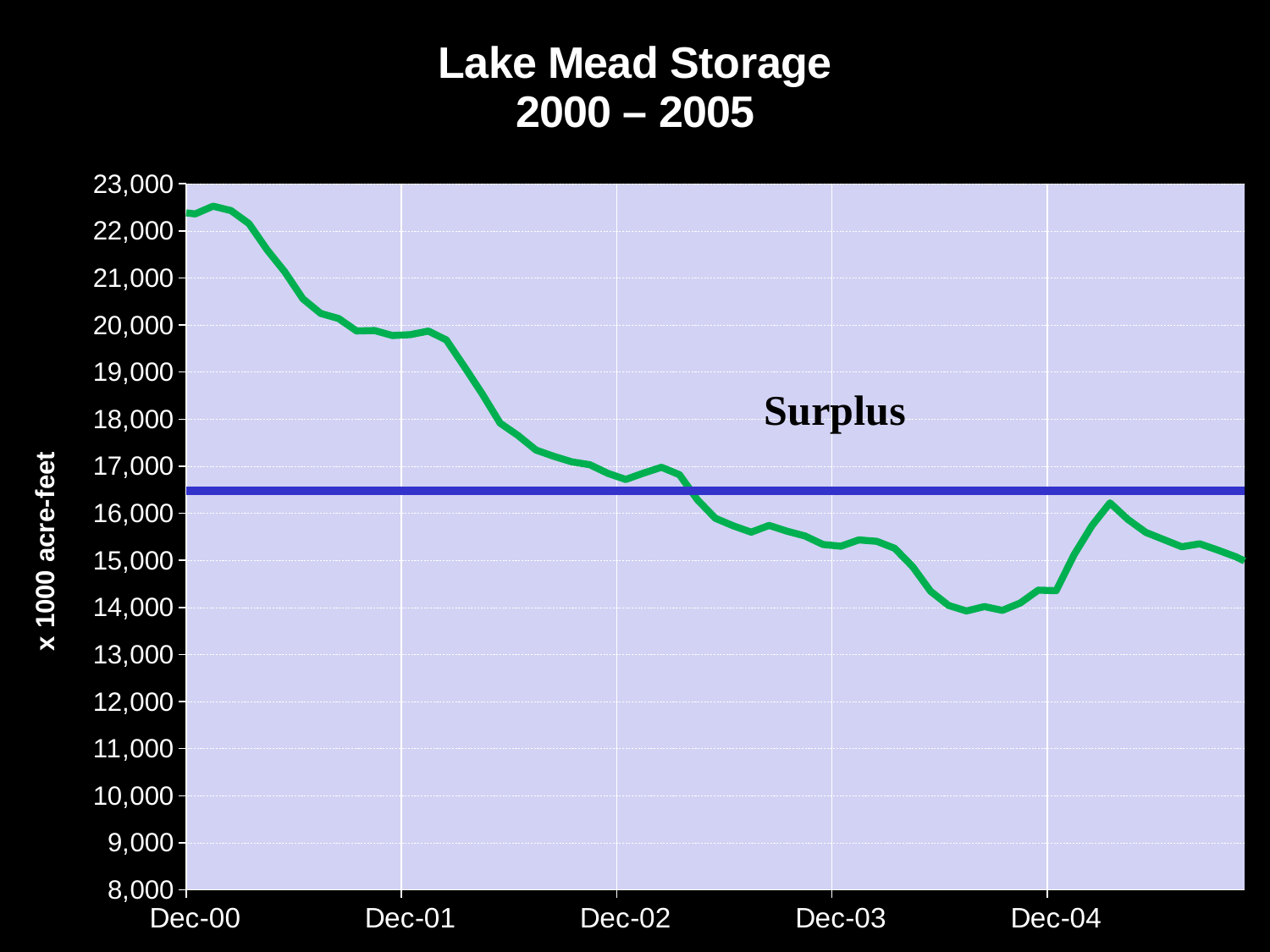
Overall, do the storage values rise or fall from Dec-00 to the end of the chart? fall What is the highest value shown on the vertical axis? 23,000 Is the storage value at Dec-04 greater or less than 15,000? less Is the storage value at Dec-02 greater or less than 16,000? greater What is the title of the chart? Lake Mead Storage 2000 – 2005 Is the storage value at Dec-00 greater or less than 22,000? greater How many date labels are shown on the horizontal axis? 5 Which has the larger storage value, Dec-00 or Dec-04? Dec-00 What is the label on the vertical axis? x 1000 acre-feet What kind of chart is shown on the slide? line chart